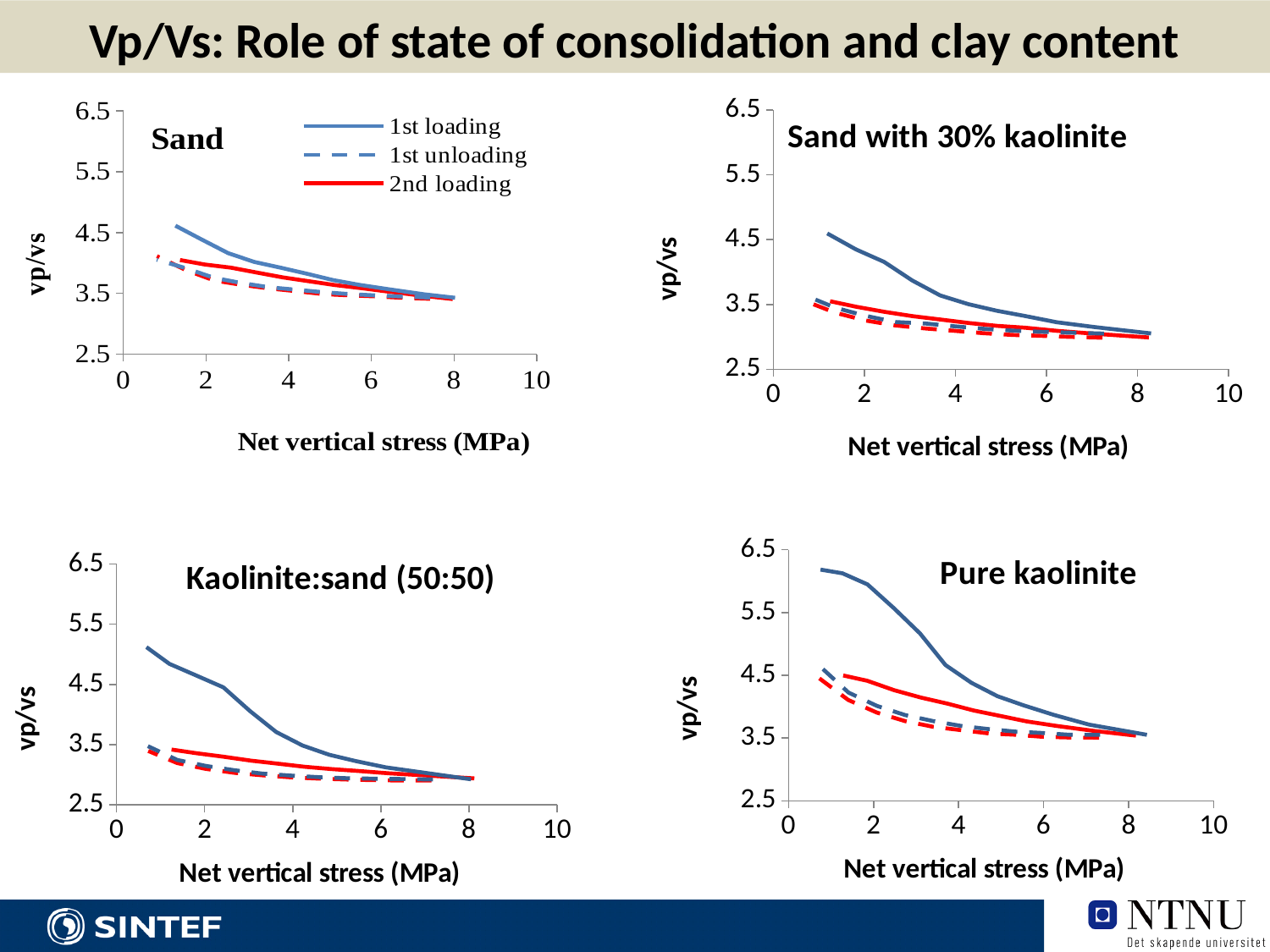
In the "Kaolinite:sand (50:50)" chart, does the 2nd loading curve rise or fall along the x axis? fall What kind of chart is the "Sand" chart? line chart In the "Sand" chart, which series is drawn as a dashed line? 1st unloading In the "Pure kaolinite" chart, at 2 MPa, which is larger: the 1st loading value or the 2nd loading value? 1st loading What is the x-axis title of the "Pure kaolinite" chart? Net vertical stress (MPa) In the "Pure kaolinite" chart, does the 1st loading curve rise or fall as net vertical stress increases? fall In the "Kaolinite:sand (50:50)" chart, is the 1st loading value at 2 MPa greater or less than 3.5? greater In the "Sand" chart, how many series does the legend list? 3 In the "Pure kaolinite" chart, is the 1st loading value at 2 MPa greater or less than 5.5? greater How many charts are shown on the slide? 4 In the "Sand with 30% kaolinite" chart, at 4 MPa, which is larger: the 1st loading value or the 1st unloading value? 1st loading In the "Sand with 30% kaolinite" chart, is the 2nd loading value at 2 MPa greater or less than 4.5? less